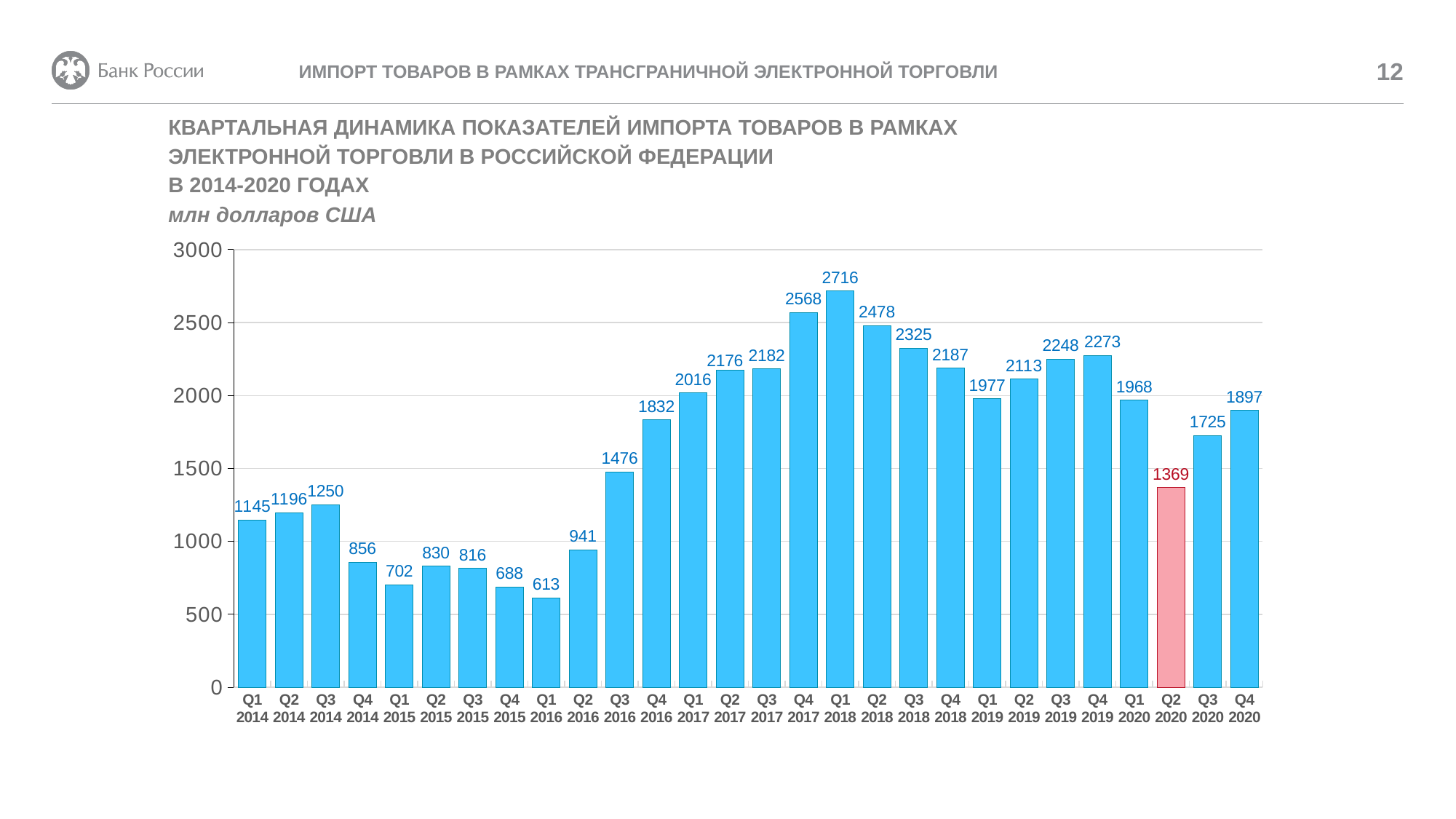
Which bar is highlighted in red instead of blue? Q2 2020 Do the values rise or fall from Q1 2016 to Q1 2018? rise What is the difference between the values for Q1 2018 and Q2 2018? 238 What is the value for Q4 2017? 2568 Which quarter has the lowest value? Q1 2016 What is the value for Q2 2020? 1369 What unit is stated under the chart title? млн долларов США Which quarter has the highest value? Q1 2018 Which is larger, the value for Q4 2019 or the value for Q3 2019? Q4 2019 Is the value for Q3 2016 greater or less than 1500? less What kind of chart is shown on the slide? bar chart How many quarterly bars are plotted on the chart? 28